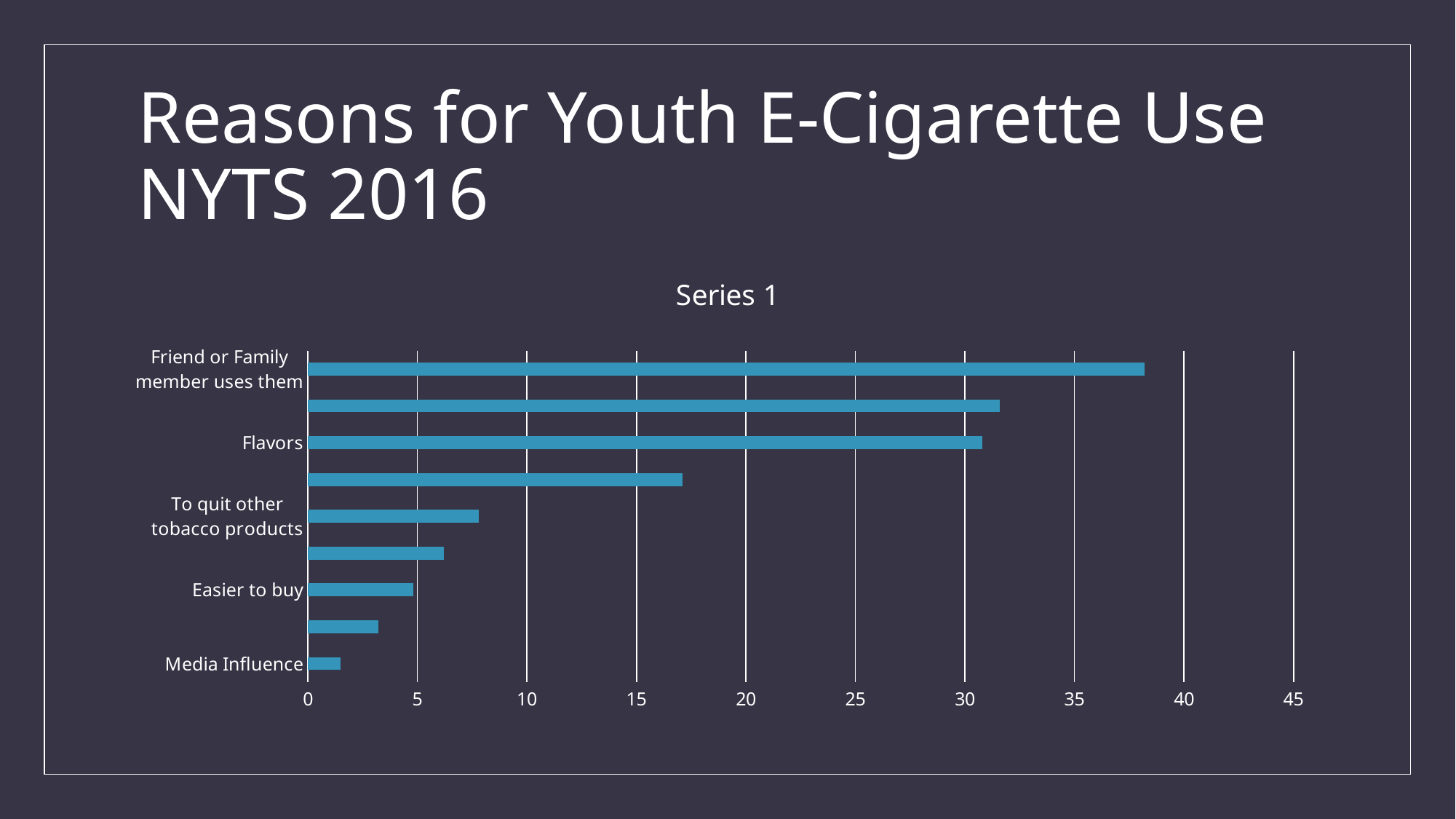
Which is larger, the value for Friend or Family member uses them or the value for Flavors? Friend or Family member uses them Is the value for To quit other tobacco products greater or less than 10? less Is the value for Flavors greater or less than 25? greater Is the value for Easier to buy greater or less than 10? less Which category has the lowest value? Media Influence Which category has the highest value? Friend or Family member uses them How many bars are plotted in the chart? 9 What is the title shown above the chart? Series 1 Which is larger, the value for Flavors or the value for To quit other tobacco products? Flavors What kind of chart is shown on the slide? bar chart